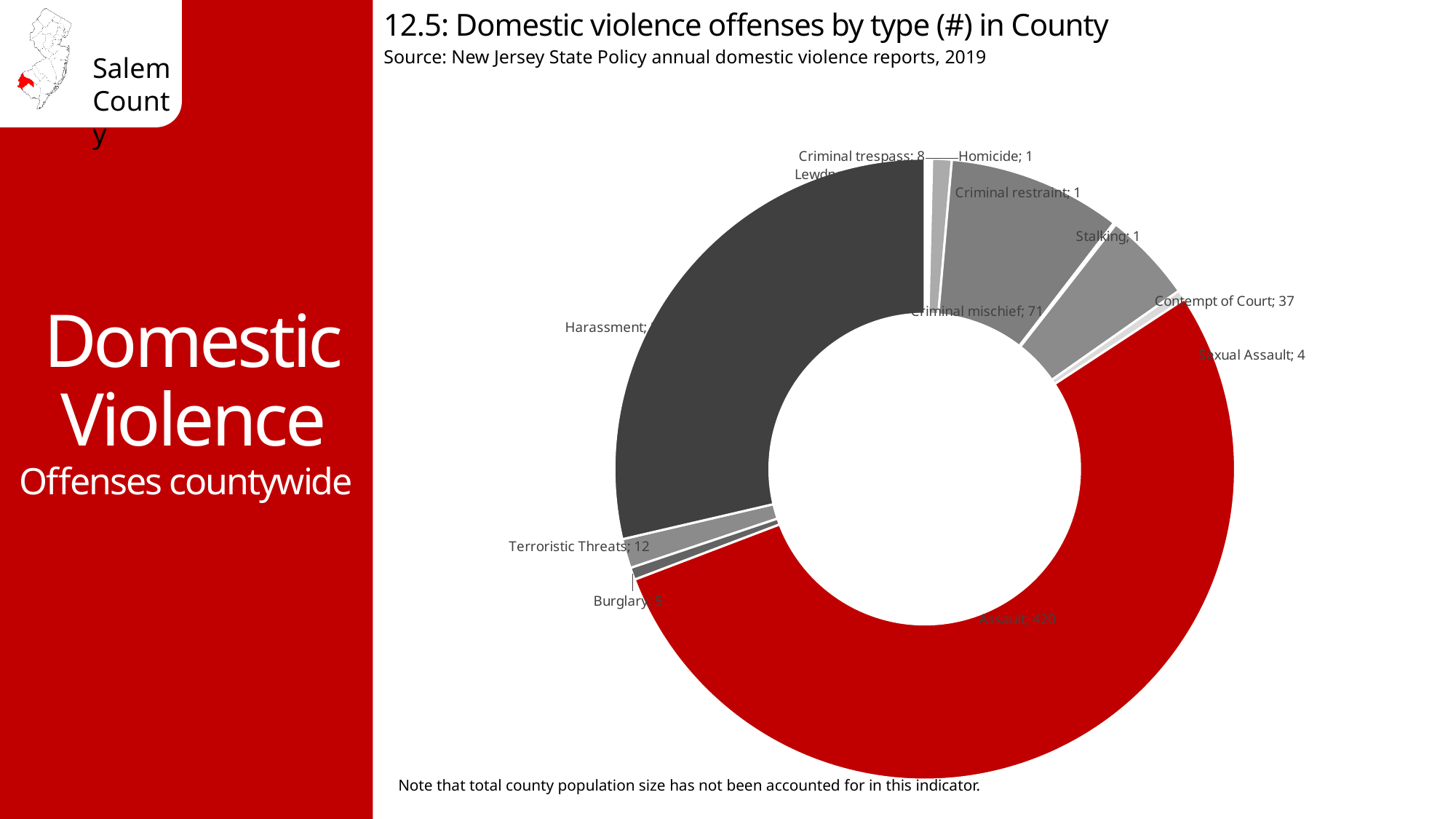
What type of chart is shown on the slide? Doughnut (pie) chart What is the source cited for the chart? New Jersey State Policy annual domestic violence reports, 2019 Which offense type has the largest slice in the chart? Assault Which is larger, the value for Contempt of Court or the value for Terroristic Threats? Contempt of Court What is the value for Terroristic Threats? 12 What is the value for Criminal mischief? 71 How many domestic violence offenses of type Assault are shown? 420 What is the value for Burglary? 5 What is the difference between the values for Criminal mischief and Contempt of Court? 34 What is the value for Contempt of Court? 37 What is the title of the chart? 12.5: Domestic violence offenses by type (#) in County What is the value for Criminal trespass? 8